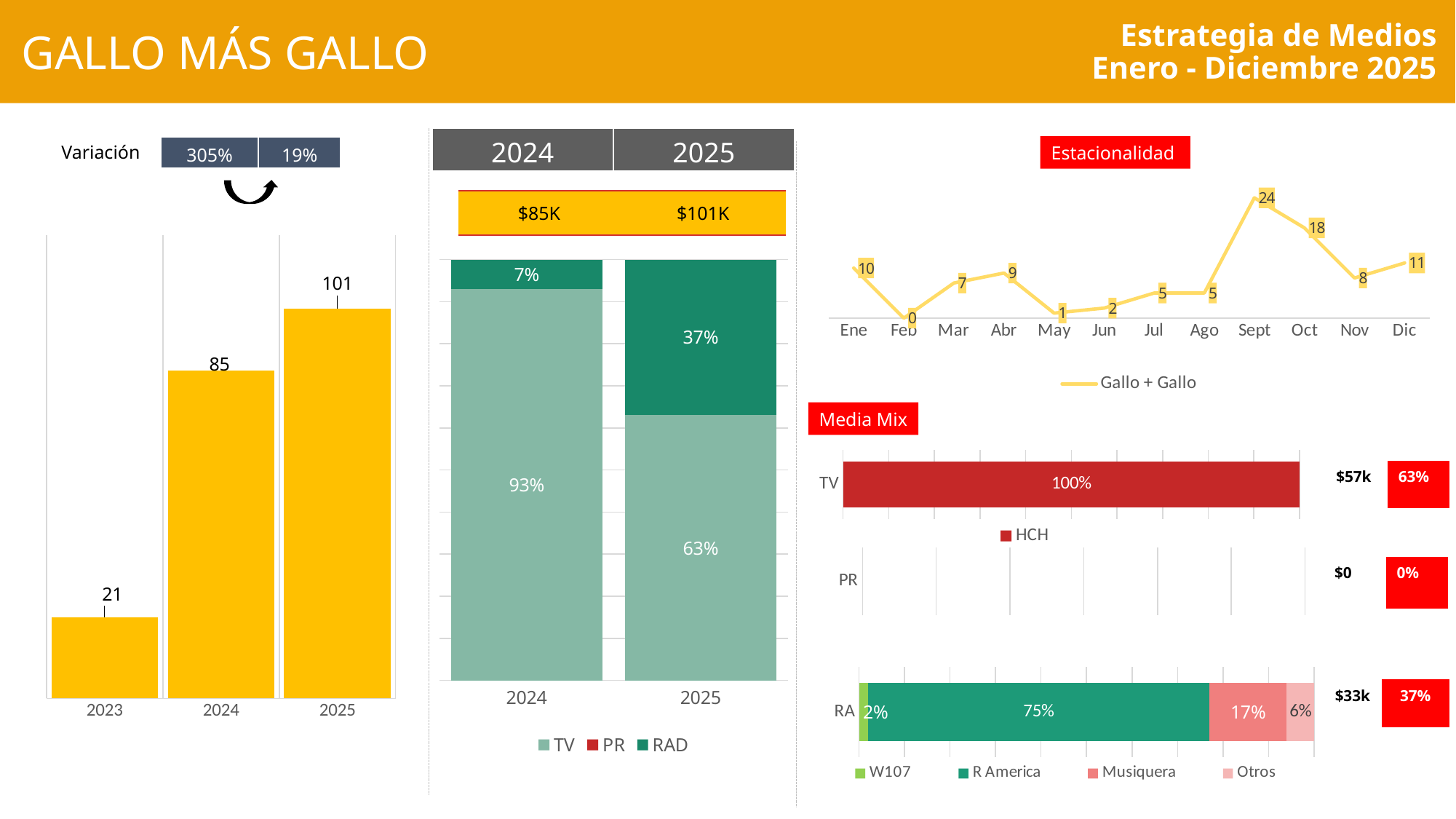
In the left bar chart, which year has the lowest value? 2023 In the Estacionalidad line chart, how many months are plotted on the x axis? 12 How many series does the legend of the middle stacked bar chart list? 3 In the middle stacked bar chart, what is the RAD share for 2025? 37% In the Media Mix chart, what is the share of R America in the RA bar? 75% In the left bar chart, what is the value for 2025? 101 In the Media Mix chart, which is larger in the RA bar: Musiquera or Otros? Musiquera In the Estacionalidad line chart, what is the value for Oct? 18 In the Estacionalidad line chart, which month has the highest value? Sept What type of chart is the left chart showing 2023, 2024 and 2025? Bar chart In the middle stacked bar chart, what is the TV share for 2024? 93% In the left bar chart, what is the difference between the values for 2024 and 2023? 64